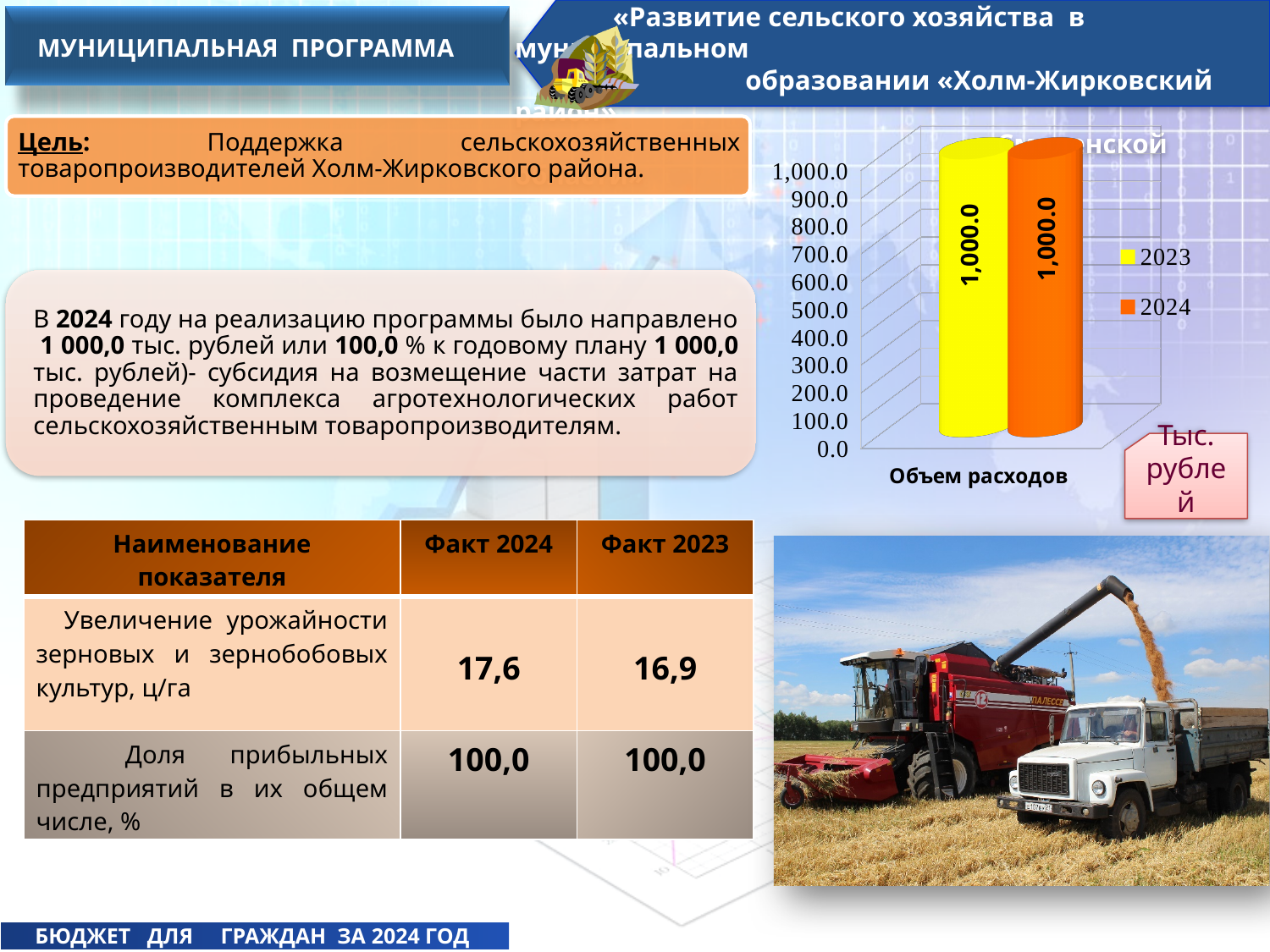
What kind of chart is shown on the slide? bar chart Is the value for 2024 greater or less than 900.0? greater What is the highest tick value shown on the chart's vertical axis? 1,000.0 How many categories are shown on the x axis of the chart? 1 What is the value of the 2024 bar for Объем расходов? 1,000.0 How many series does the chart legend list? 2 What is the category label shown under the bars? Объем расходов Which colour represents the 2024 series in the chart legend? orange What is the value of the 2023 bar for Объем расходов? 1,000.0 Is the value for 2023 greater or less than 500.0? greater What is the difference between the 2024 and 2023 values for Объем расходов? 0.0